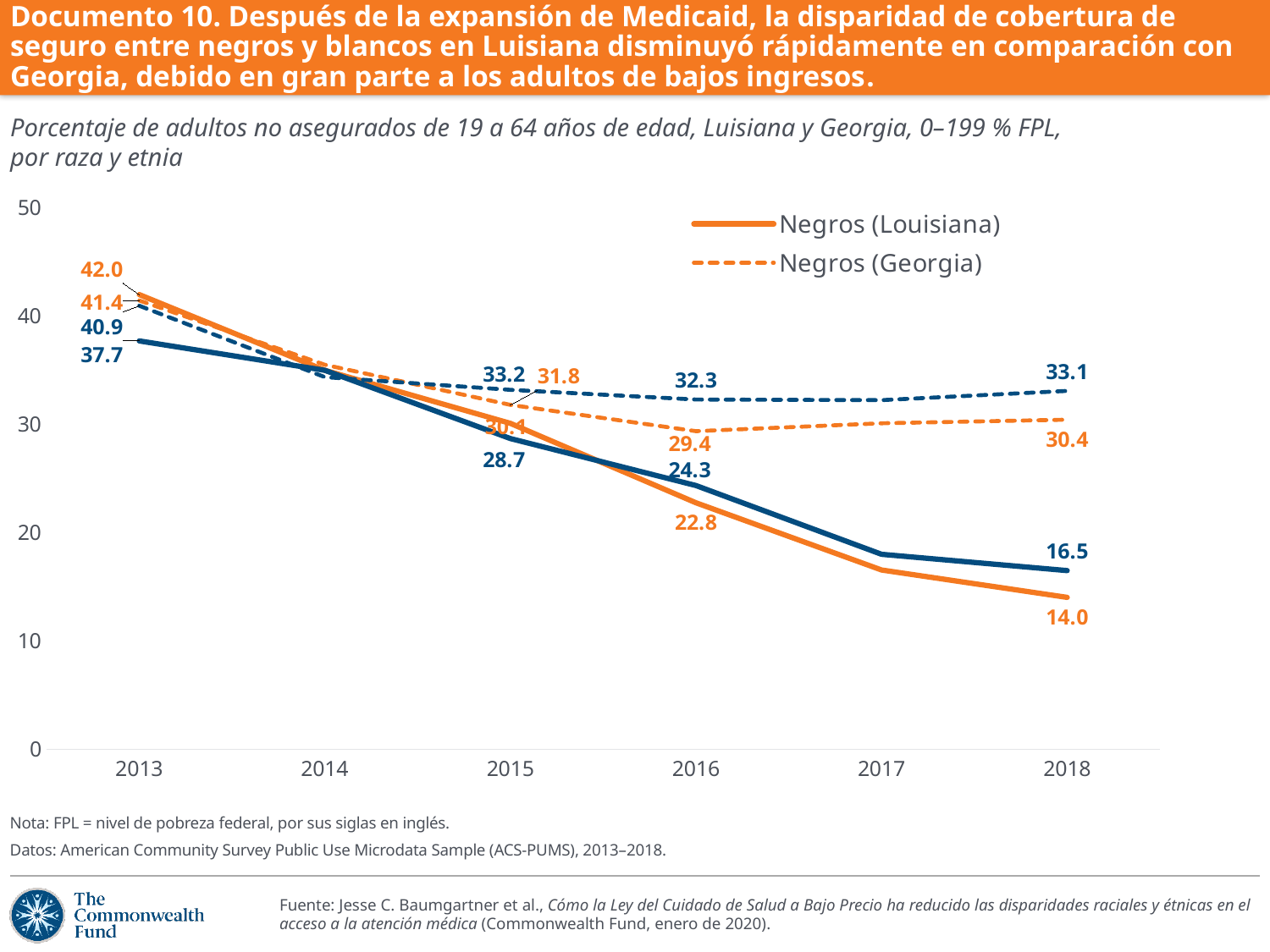
What is the value for Negros (Louisiana) in 2013? 42.0 What is the value for Negros (Georgia) in 2018? 30.4 What is the value for Negros (Georgia) in 2013? 41.4 How many years are shown on the x axis of the chart? 6 Is the value for Negros (Louisiana) in 2017 greater or less than 20? less How many series does the chart legend list? 2 What is the difference between Negros (Georgia) and Negros (Louisiana) in 2018? 16.4 In which year is the value for Negros (Louisiana) lowest? 2018 Which is larger in 2016, Negros (Georgia) or Negros (Louisiana)? Negros (Georgia) Does the value for Negros (Louisiana) rise or fall from 2013 to 2018? Fall What type of chart is shown on the slide? Line chart What is the value for Negros (Louisiana) in 2016? 22.8